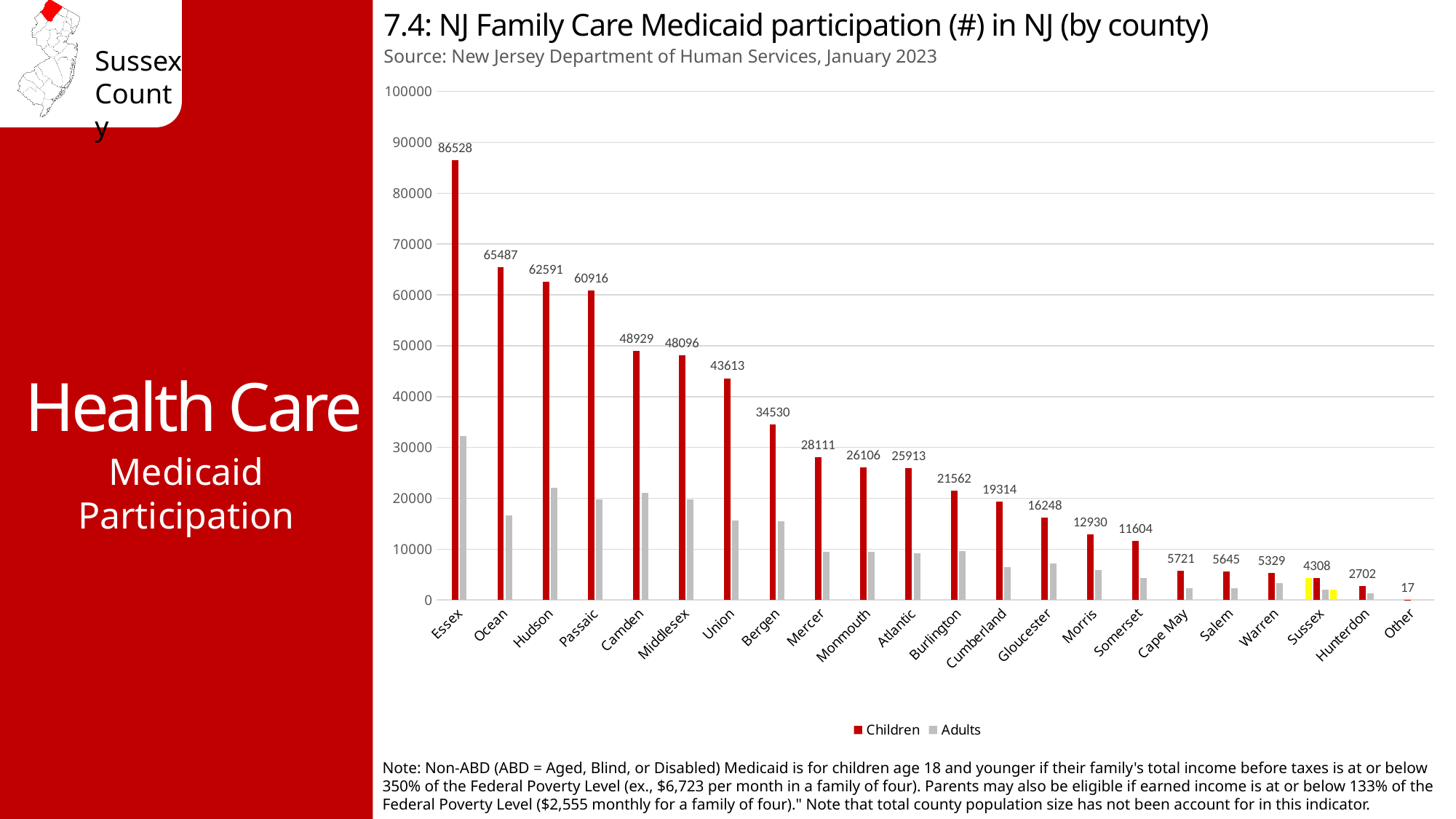
Which category has the lowest Children value? Other Which has a larger Children value, Camden or Middlesex? Camden What is the Children value for Hunterdon? 2702 How many series does the legend list? 2 Which county has the highest Children value? Essex Is the Adults value for Essex greater or less than 30000? greater Do the Children values rise or fall moving from left to right along the x axis? fall How many categories are shown on the x axis? 22 What is the difference between the Children values for Ocean and Hudson? 2896 What is the Children value for Sussex? 4308 What type of chart is shown on the slide? bar chart What is the Children value for Essex? 86528